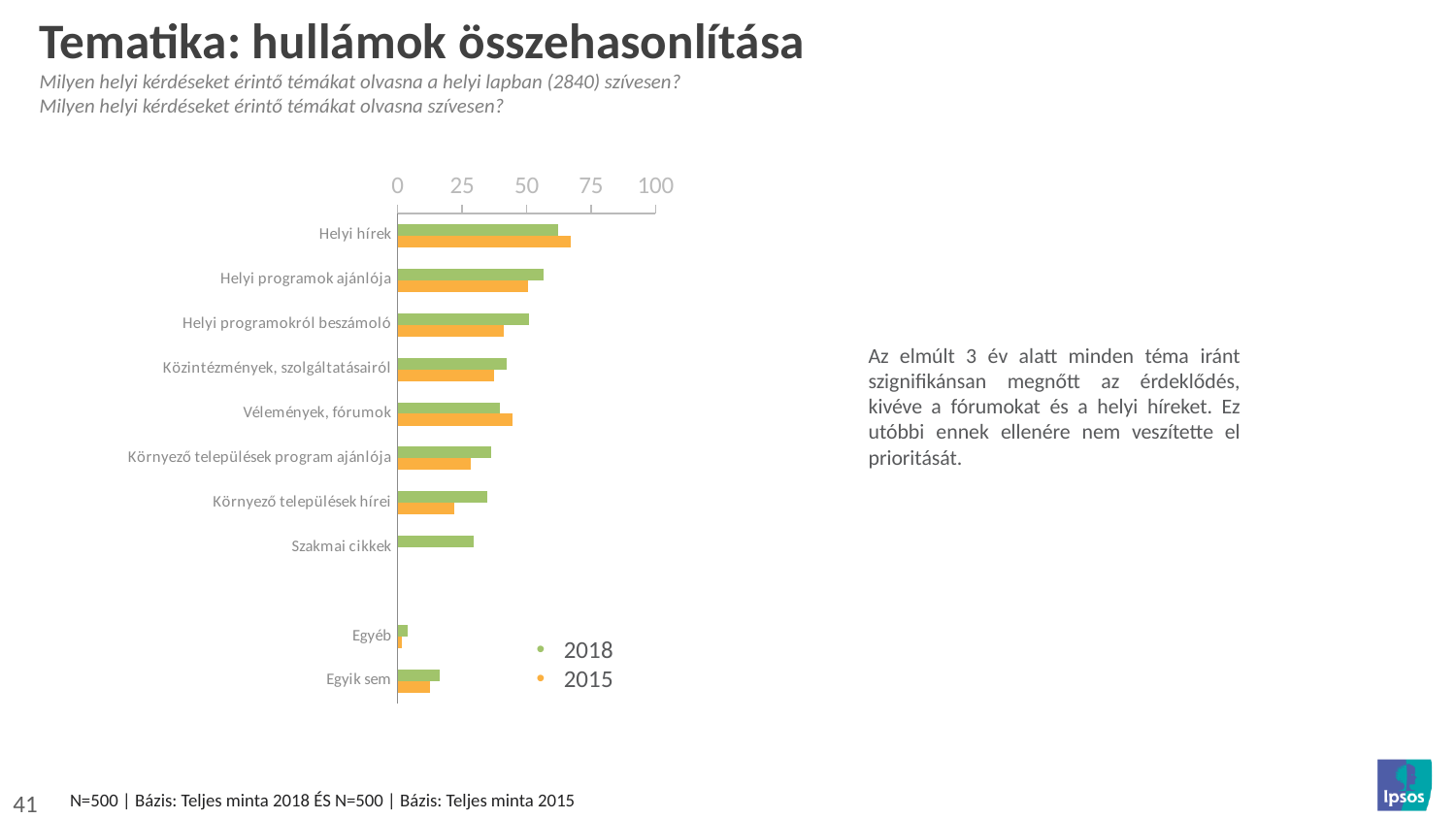
Which category has the highest value for 2018? Helyi hírek How many categories are plotted on the chart? 10 Which colour represents the 2015 series in the legend? orange For Helyi hírek, which series has the larger value, 2018 or 2015? 2015 Is the 2015 value for Helyi programokról beszámoló greater or less than 50? less Which category has the highest value for 2015? Helyi hírek Which category has the lowest value for 2018? Egyéb How many series does the legend list? 2 Is the 2015 value for Helyi hírek greater or less than 50? greater What kind of chart is shown on the slide? bar chart For Környező települések hírei, which series has the larger value, 2018 or 2015? 2018 Is the 2018 value for Egyik sem greater or less than 25? less